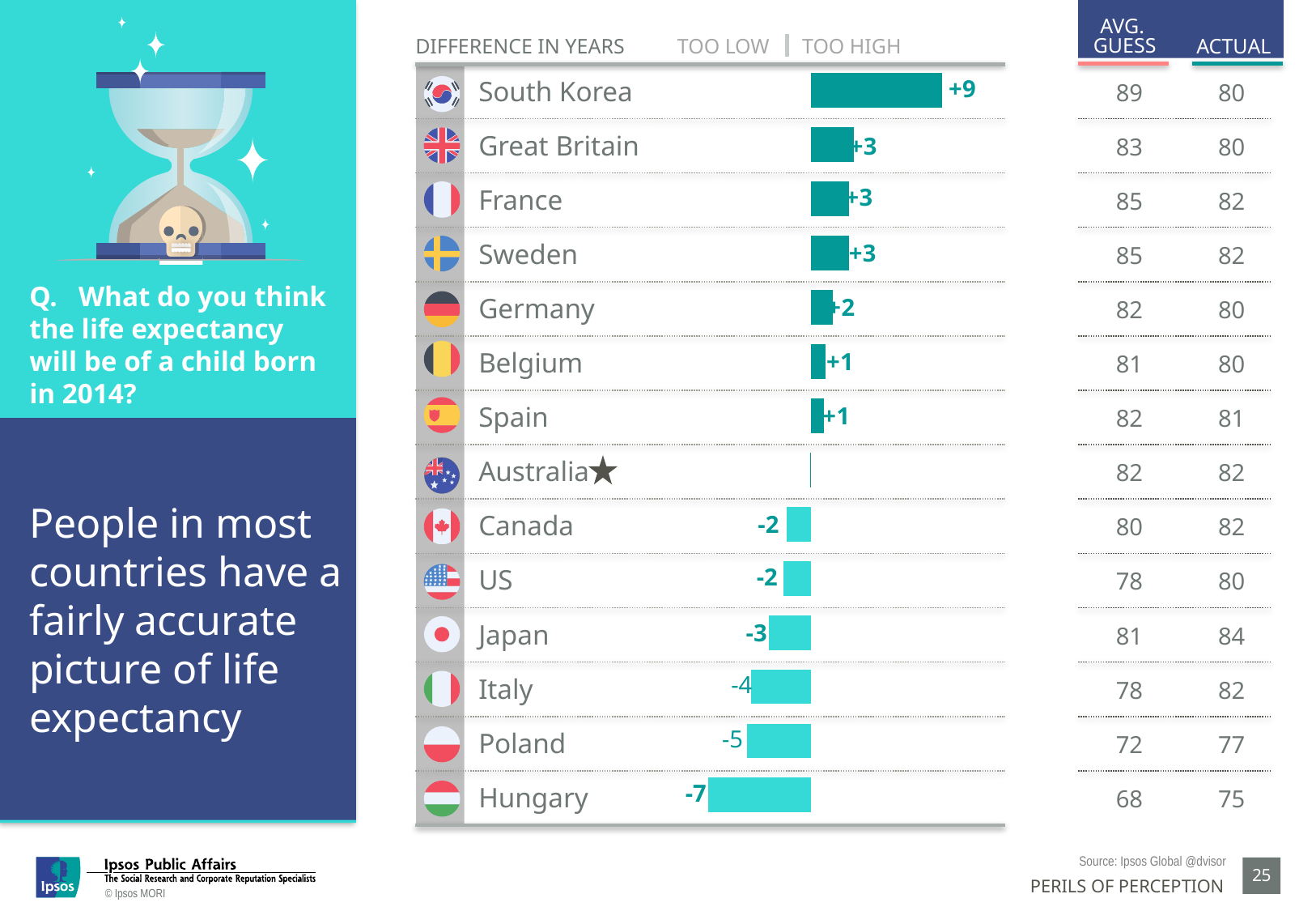
Which country has the lowest difference in years (guessed too low by the most)? Hungary Which country has the highest difference in years (guessed too high by the most)? South Korea What kind of chart is used to show the difference in years? bar chart What is the gap between the average guess and the actual life expectancy for South Korea? 9 What is the difference in years shown for Hungary? -7 Is the difference in years for Germany larger or smaller than that for Belgium? larger What is the actual life expectancy shown for Japan? 84 Do the difference values rise or fall going from the top of the chart to the bottom? fall How many countries are listed in the chart? 14 What is the title of the chart showing the bars? DIFFERENCE IN YEARS What is the difference in years shown for South Korea? +9 What is the average guess for life expectancy in Poland? 72